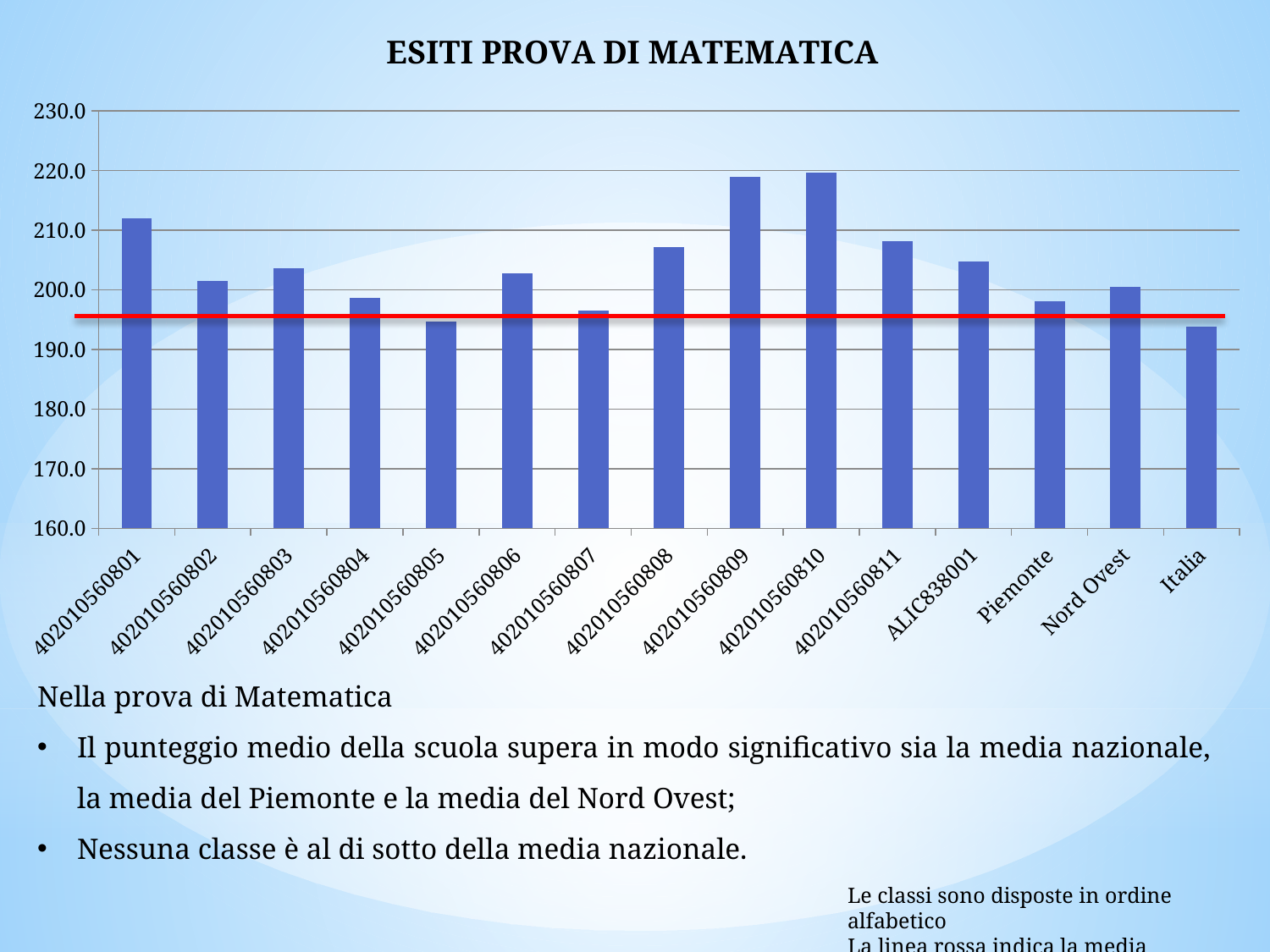
Which has the larger value, 402010560807 or 402010560808? 402010560808 Is the value for 402010560809 greater or less than 210? greater What colour is the horizontal line drawn across the chart? red Which has the larger value, 402010560801 or 402010560802? 402010560801 What type of chart is shown on the slide? bar chart Is the value for 402010560811 greater or less than 200? greater Is the value for 402010560805 greater or less than 200? less How many categories are shown on the x axis of the chart? 15 Which has the larger value, 402010560809 or Piemonte? 402010560809 What is the title of the chart? ESITI PROVA DI MATEMATICA